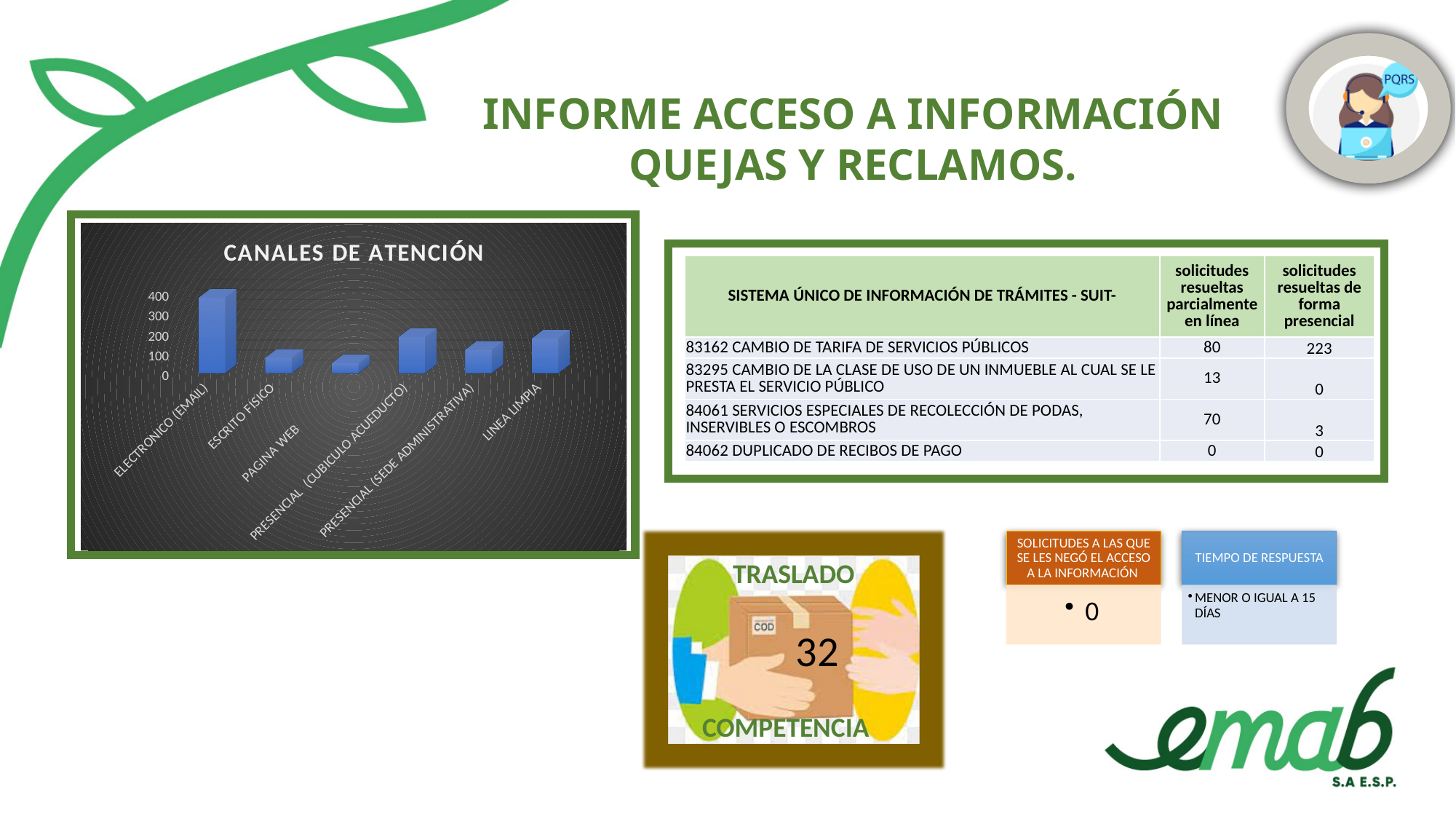
What kind of chart is the 'CANALES DE ATENCIÓN' chart? bar chart In the 'CANALES DE ATENCIÓN' chart, is the value for PAGINA WEB greater or less than 100? less In the 'CANALES DE ATENCIÓN' chart, which is larger: PAGINA WEB or LINEA LIMPIA? LINEA LIMPIA What is the title of the chart on the slide? CANALES DE ATENCIÓN How many categories are shown in the 'CANALES DE ATENCIÓN' chart? 6 Which category has the highest value in the 'CANALES DE ATENCIÓN' chart? ELECTRONICO (EMAIL) In the 'CANALES DE ATENCIÓN' chart, is the value for ESCRITO FISICO greater or less than 200? less In the 'CANALES DE ATENCIÓN' chart, is the value for ELECTRONICO (EMAIL) greater or less than 300? greater What is the highest value shown on the vertical axis of the 'CANALES DE ATENCIÓN' chart? 400 Which category has the lowest value in the 'CANALES DE ATENCIÓN' chart? PAGINA WEB In the 'CANALES DE ATENCIÓN' chart, which is larger: ELECTRONICO (EMAIL) or ESCRITO FISICO? ELECTRONICO (EMAIL)